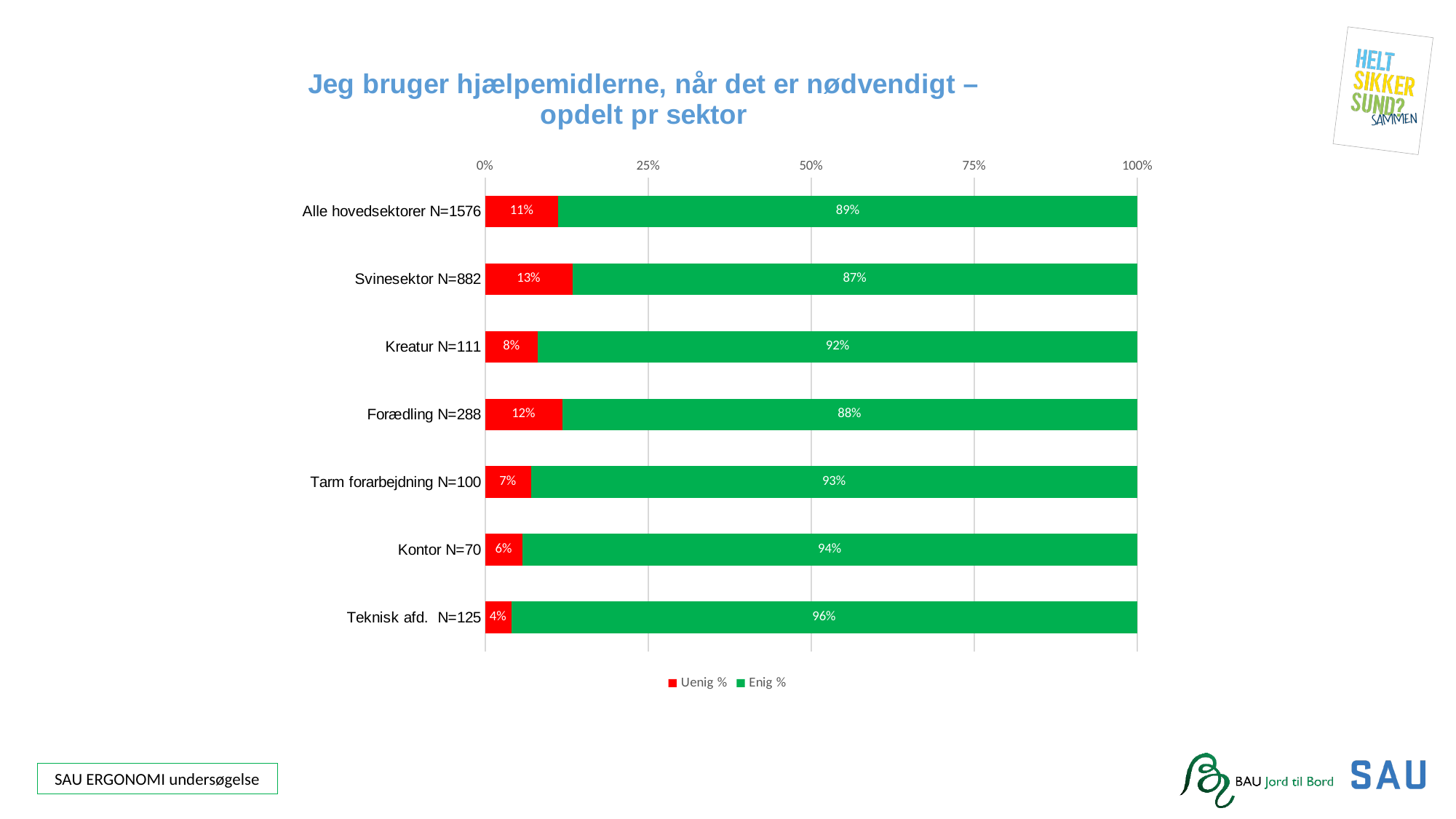
How many categories are shown on the chart? 7 What kind of chart is shown on the slide? Stacked bar chart Which category has the highest Enig % value? Teknisk afd. N=125 What is the Enig % value for Kreatur N=111? 92% What is the difference between the Enig % values for Kontor N=70 and Forædling N=288? 6% Which category has the highest Uenig % value? Svinesektor N=882 Which is larger, the Uenig % value for Forædling N=288 or for Tarm forarbejdning N=100? Forædling N=288 What is the Uenig % value for Svinesektor N=882? 13% What is the Enig % value for Alle hovedsektorer N=1576? 89% How many series does the legend list? 2 What colour represents the Enig % series? Green Which category has the lowest Uenig % value? Teknisk afd. N=125